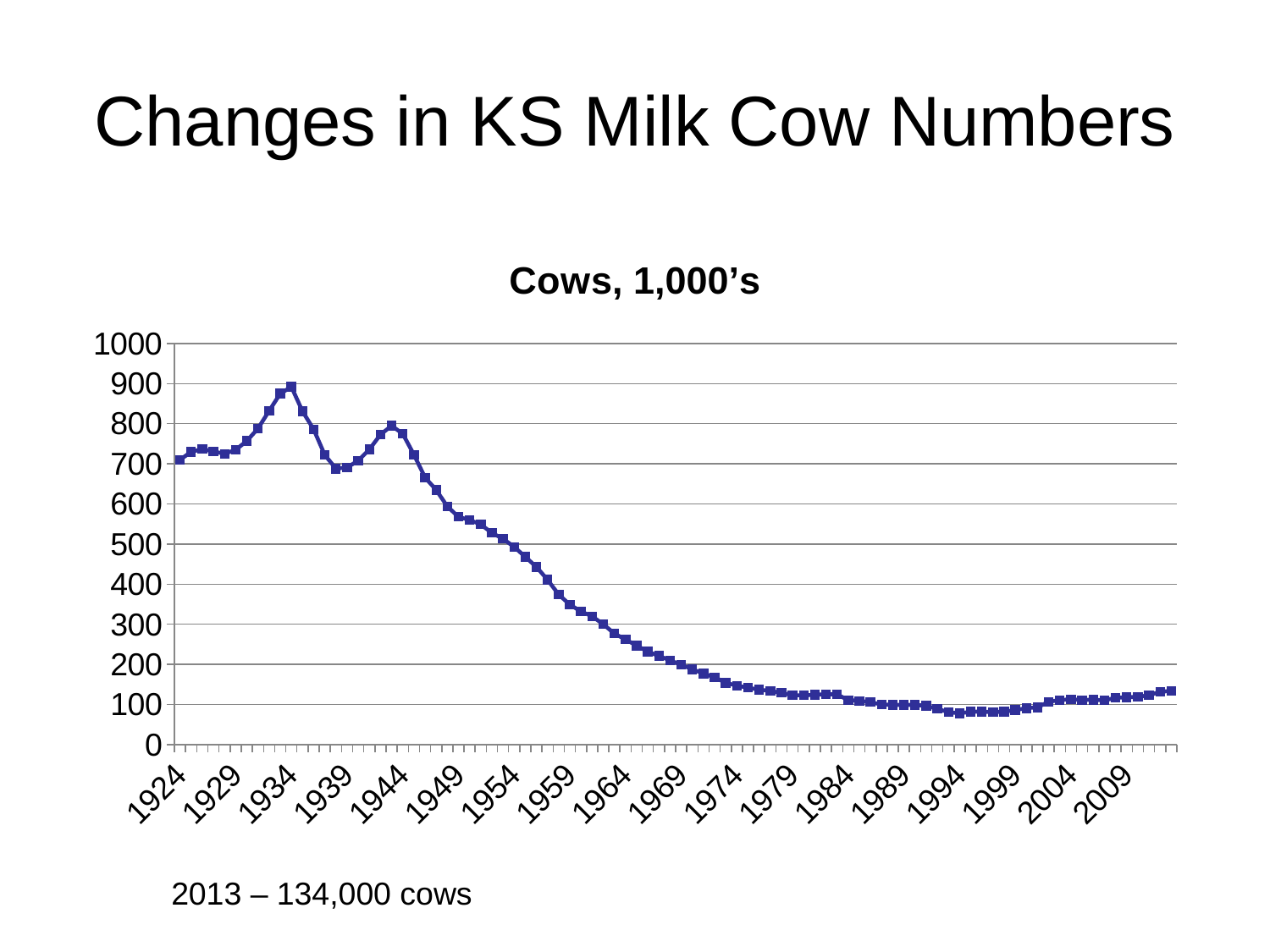
Is the value for 1979 greater or less than 200? less Is the value for 1924 greater or less than 600? greater What kind of chart is shown on the slide? line chart What is the title of the chart? Cows, 1,000's How many data series are plotted on the chart? 1 Which year has the larger value, 1934 or 1944? 1934 Overall, do the values rise or fall from 1924 to 2009? fall Is the value for 1954 greater or less than 400? greater Do the values rise or fall from 1994 to 2009? rise Which year has the larger value, 1949 or 1964? 1949